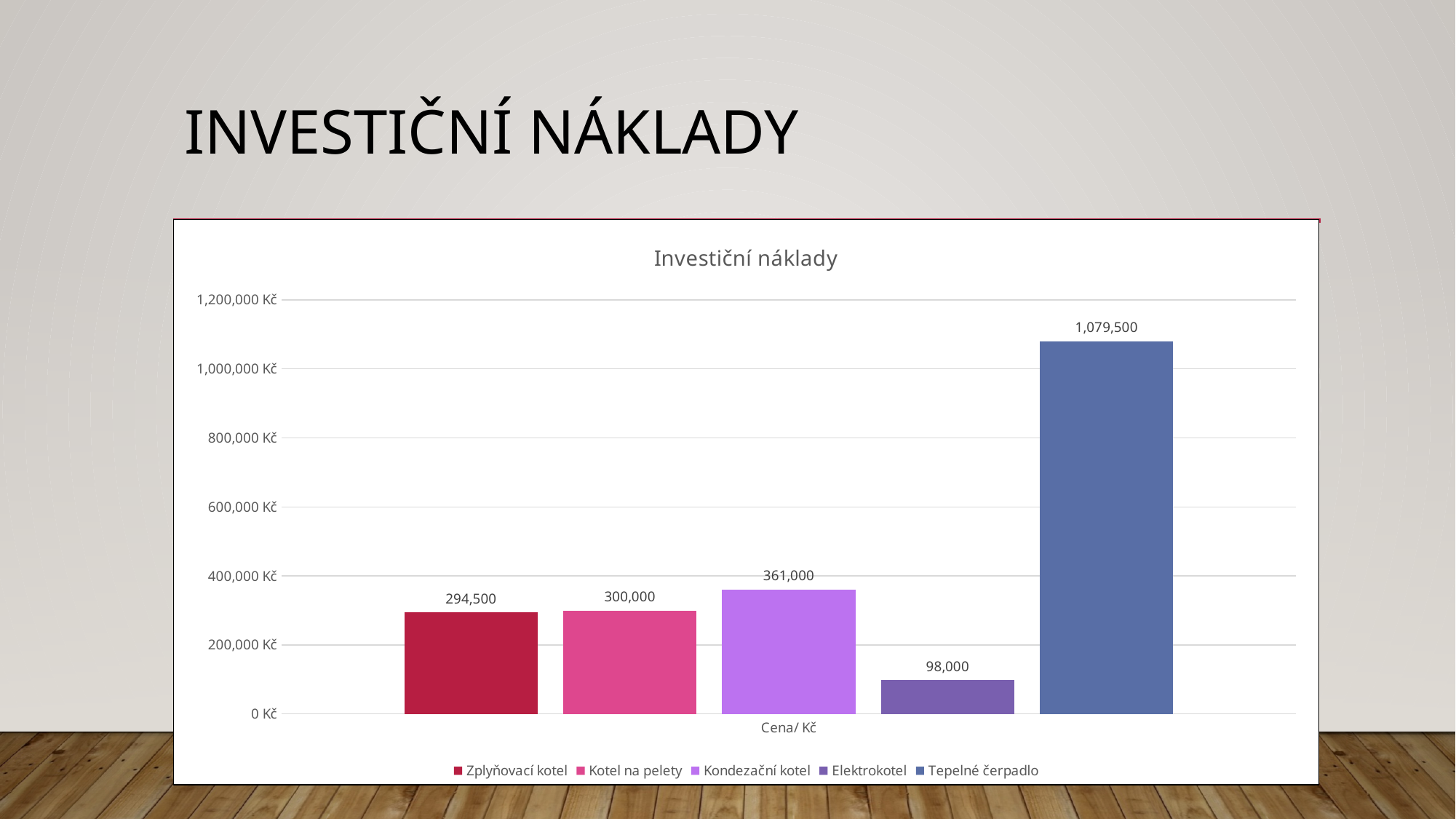
What is the value for Zplyňovací kotel? 294,500 Which series has the highest value? Tepelné čerpadlo Which series has the lowest value? Elektrokotel How many series does the legend list? 5 Which is larger, the value for Kondezační kotel or the value for Kotel na pelety? Kondezační kotel What is the title of the chart? Investiční náklady What kind of chart is shown on the slide? Bar chart What is the value for Elektrokotel? 98,000 What is the value for Kotel na pelety? 300,000 What is the value for Tepelné čerpadlo? 1,079,500 What is the value for Kondezační kotel? 361,000 What is the difference between the values for Tepelné čerpadlo and Kondezační kotel? 718,500